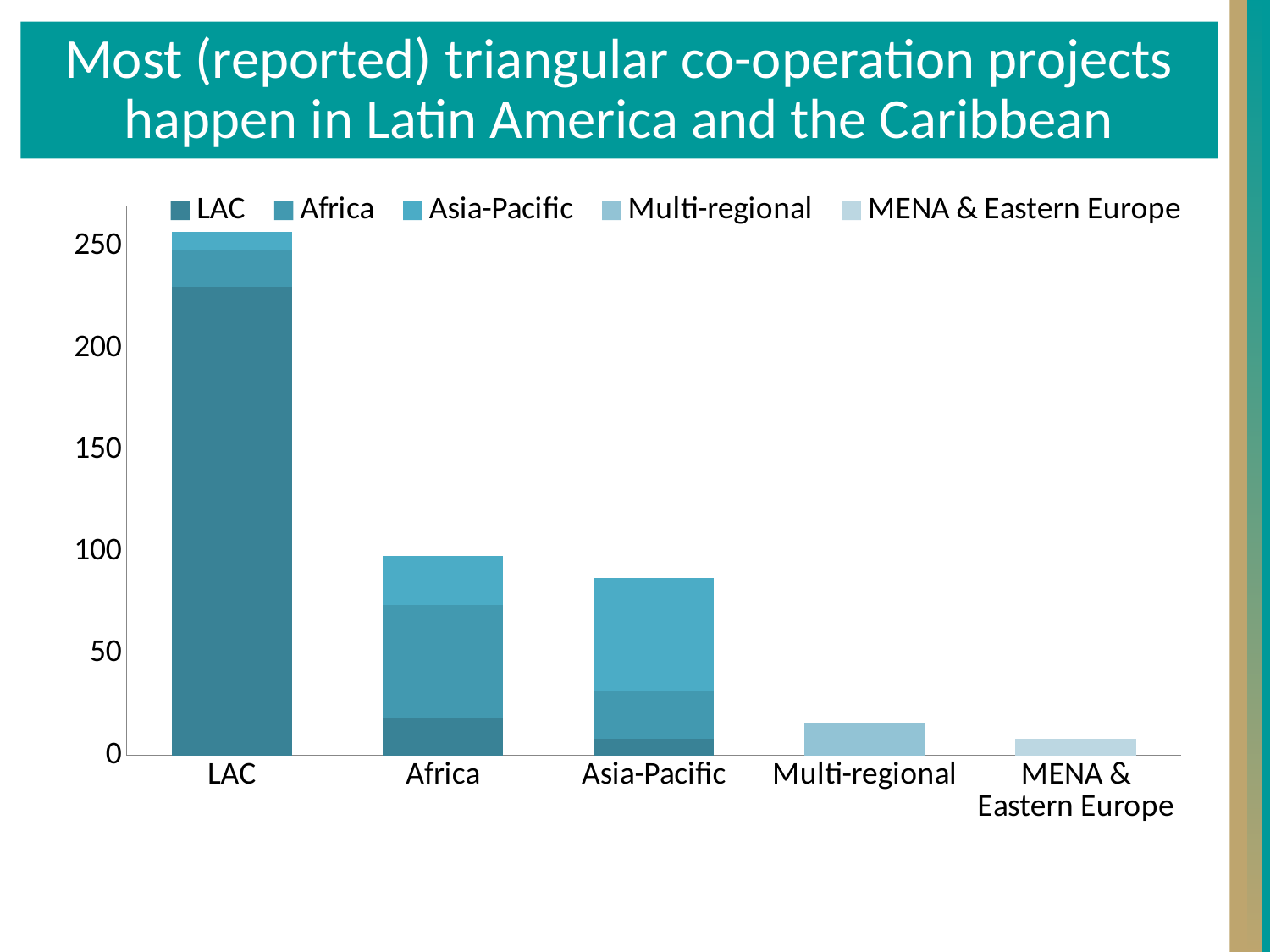
How many series does the chart's legend list? 5 Is the total value of the LAC bar greater or less than 200? greater Which category has the shortest bar in the chart? MENA & Eastern Europe Is the total value of the Asia-Pacific bar greater or less than 50? greater How many categories are shown on the x axis of the chart? 5 Which bar is taller, LAC or Africa? LAC Which bar is taller, Multi-regional or MENA & Eastern Europe? Multi-regional What kind of chart is shown on the slide? bar chart Is the value of the Multi-regional bar greater or less than 50? less Which category has the tallest bar in the chart? LAC What is the title of the slide containing the chart? Most (reported) triangular co-operation projects happen in Latin America and the Caribbean